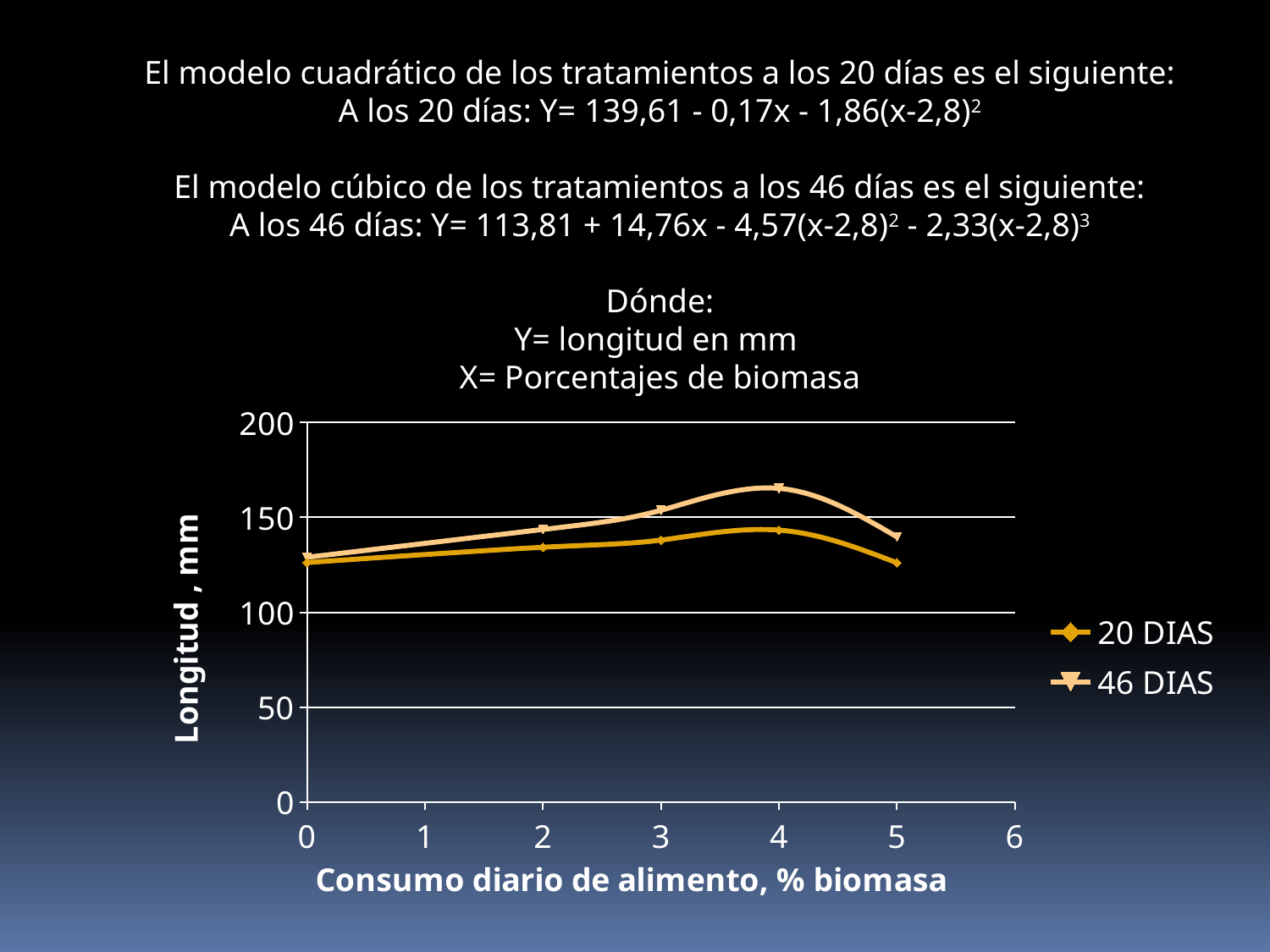
What kind of chart is shown on the slide? line chart Is the value for 20 DIAS at a daily consumption of 4 greater or less than 150? less Is the value for 20 DIAS at a daily consumption of 0 greater or less than 100? greater At a daily consumption of 4, which series has the larger value, 20 DIAS or 46 DIAS? 46 DIAS Is the value for 46 DIAS at a daily consumption of 4 greater or less than 150? greater What is the title of the y axis? Longitud , mm How many data points are plotted for the 46 DIAS series? 5 Between a daily consumption of 4 and 5, do the values of the 46 DIAS series rise or fall? fall At which daily consumption value does the 46 DIAS series reach its highest point? 4 How many series does the legend list? 2 What are the two series named in the legend? 20 DIAS and 46 DIAS